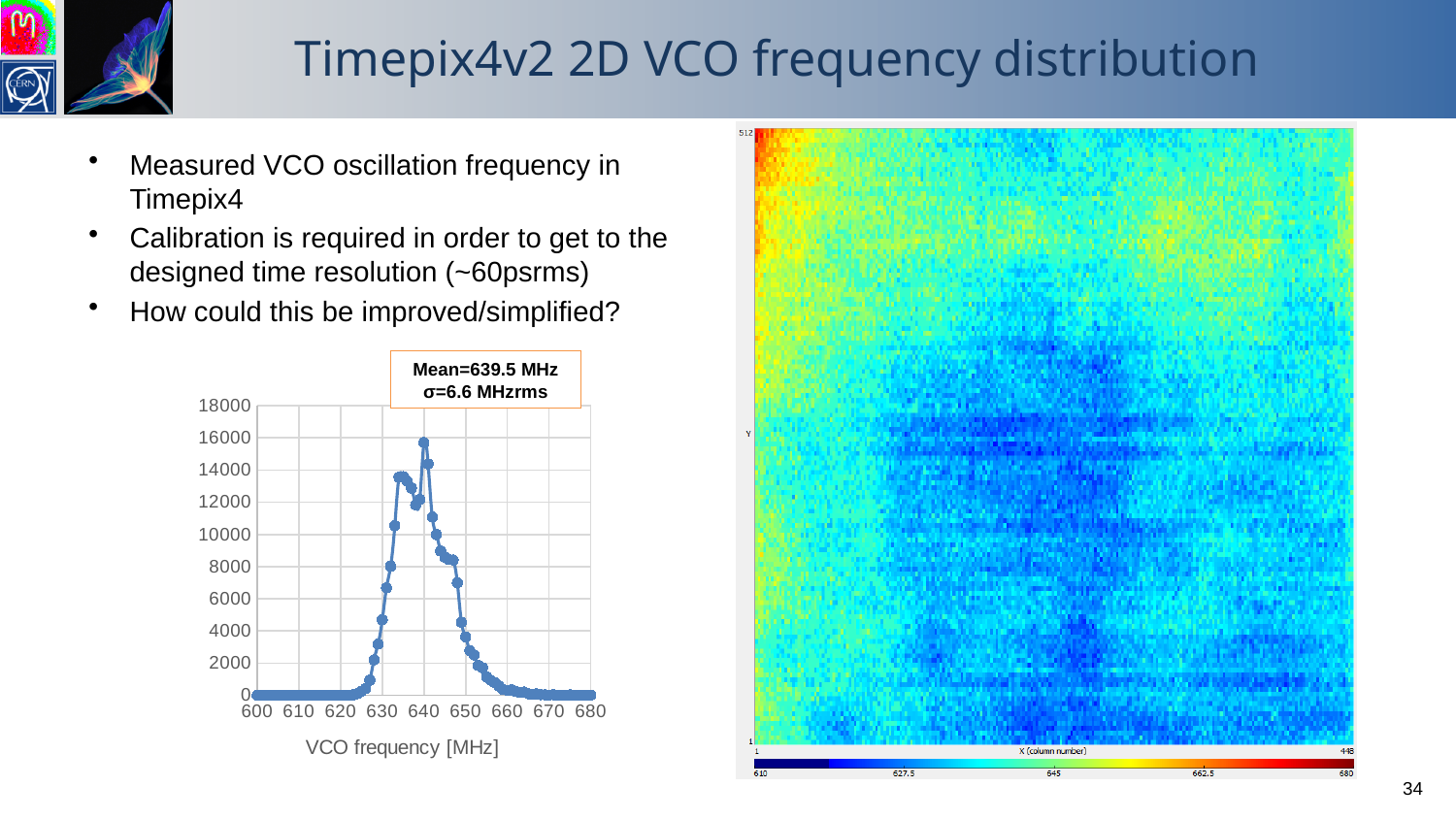
What is the x-axis label of the chart on the left of the slide? VCO frequency [MHz] What mean value is printed in the annotation box on the left chart? Mean=639.5 MHz What kind of chart is the one on the right of the slide? heatmap What kind of chart is the one on the left of the slide? line chart On the left chart, do the values rise or fall as the frequency goes from 620 MHz to 640 MHz? rise On the right chart, what is the maximum value shown on the colour scale? 680 On the left chart, is the peak value near 640 MHz greater or less than 14000? greater What sigma value is printed in the annotation box on the left chart? σ=6.6 MHzrms On the left chart, is the value at 620 MHz greater or less than 2000? less What is the highest tick value on the y axis of the left chart? 18000 On the left chart, do the values rise or fall as the frequency goes from 640 MHz to 680 MHz? fall On the left chart, is the value at 660 MHz greater or less than 2000? less